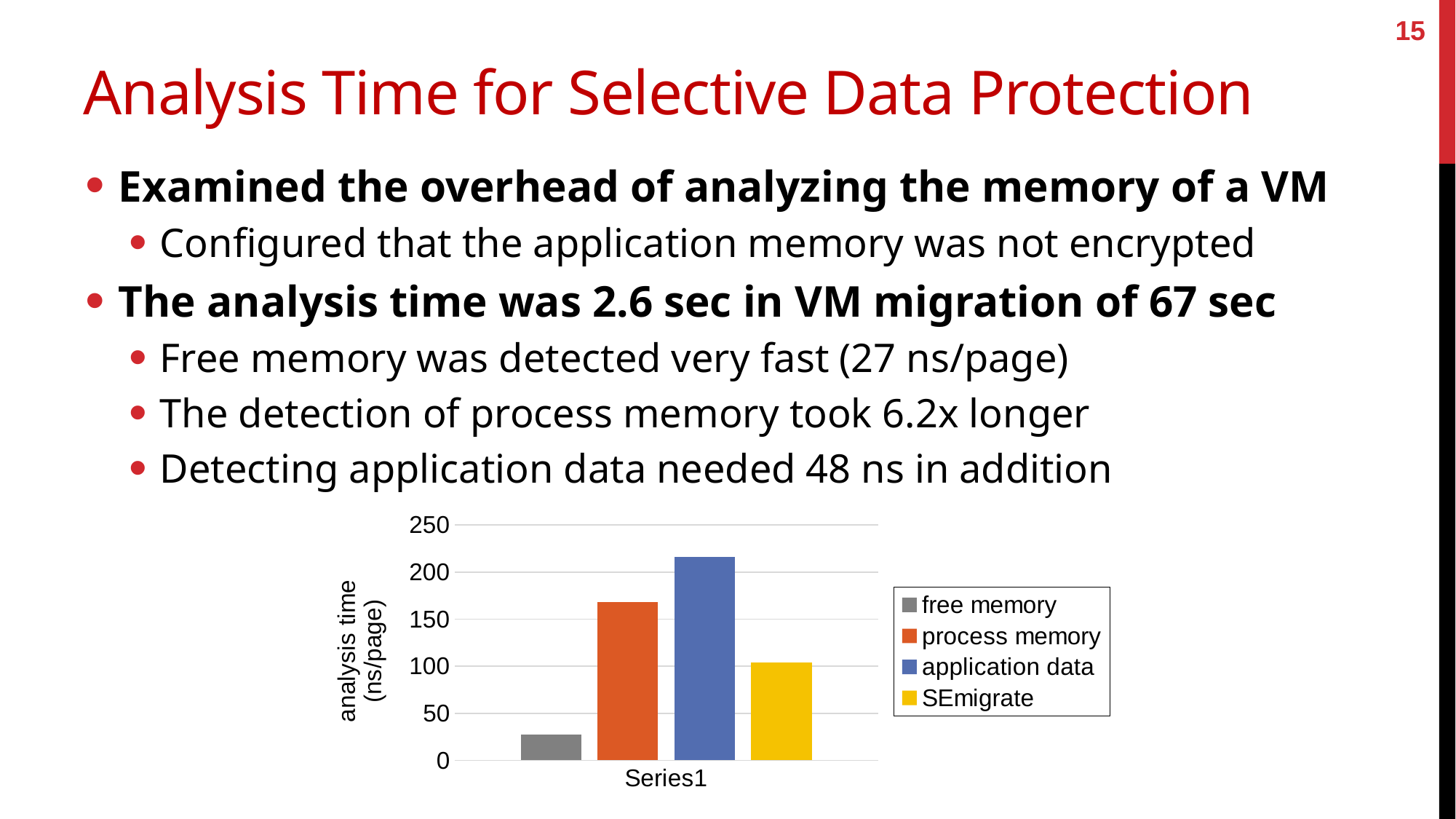
What kind of chart is shown on the slide? bar chart Which series has the lowest analysis time? free memory Which has a larger analysis time, process memory or SEmigrate? process memory Which has a larger analysis time, application data or process memory? application data Is the value for free memory greater or less than 50? less Is the value for SEmigrate greater or less than 150? less How many series does the legend list? 4 Which series has the highest analysis time? application data What colour is the bar for SEmigrate? yellow What is the label of the y axis? analysis time (ns/page) Is the value for process memory greater or less than 150? greater